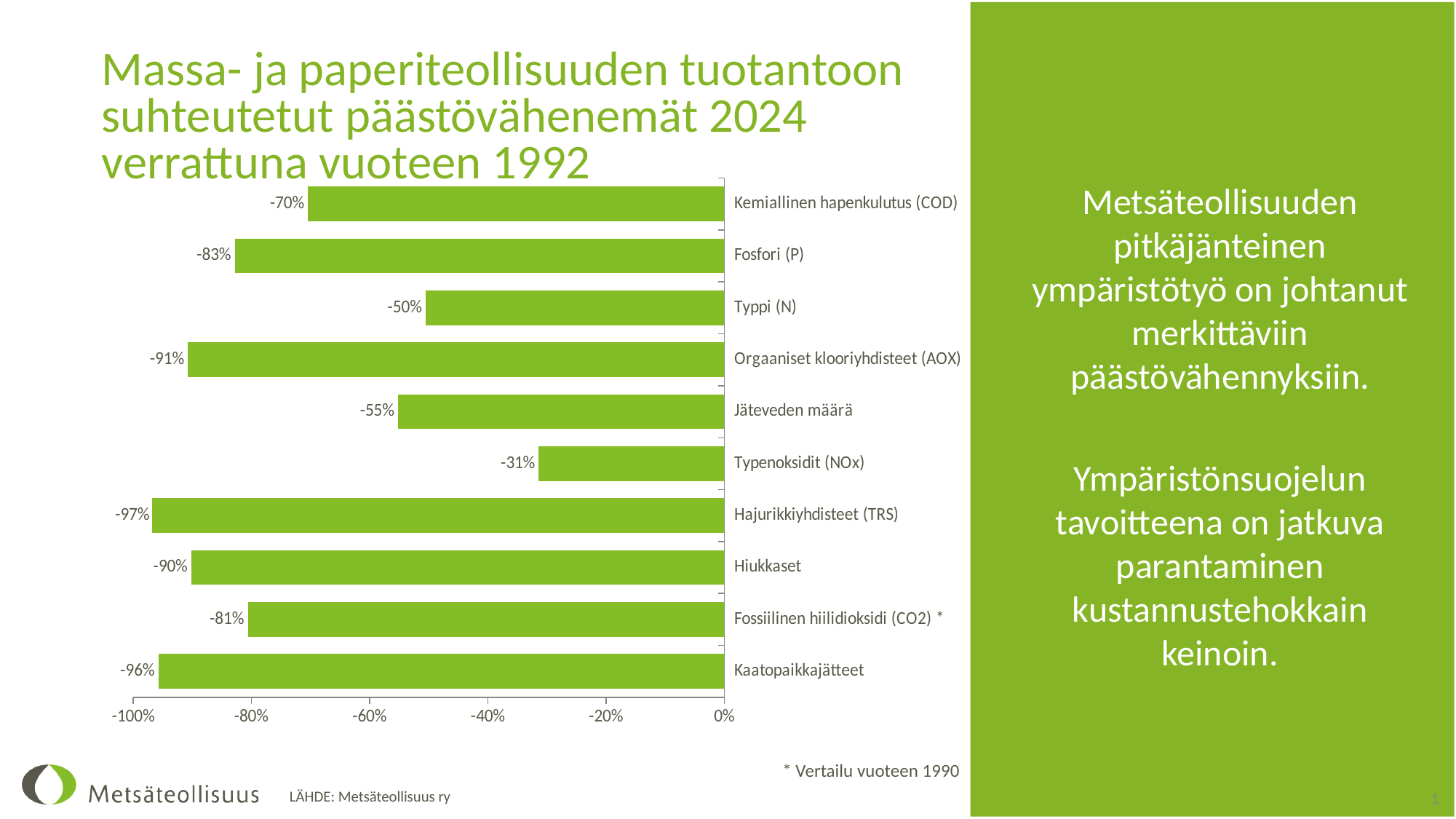
What kind of chart is shown on the slide? Bar chart What is the value shown for Jäteveden määrä? -55% What is the value shown for Fossiilinen hiilidioksidi (CO2)? -81% How many categories are plotted in the chart? 10 What is the value shown for Kaatopaikkajätteet? -96% Which category shows the largest reduction (the most negative value)? Hajurikkiyhdisteet (TRS) What is the value shown for Typenoksidit (NOx)? -31% What is the value shown for Kemiallinen hapenkulutus (COD)? -70% Which shows a larger reduction, Orgaaniset klooriyhdisteet (AOX) or Hiukkaset? Orgaaniset klooriyhdisteet (AOX) Which category shows the smallest reduction (the value closest to 0%)? Typenoksidit (NOx) According to the footnote, which year is the comparison year for the category marked with an asterisk? 1990 By how many percentage points does the reduction for Fosfori (P) exceed the reduction for Typpi (N)? 33 percentage points